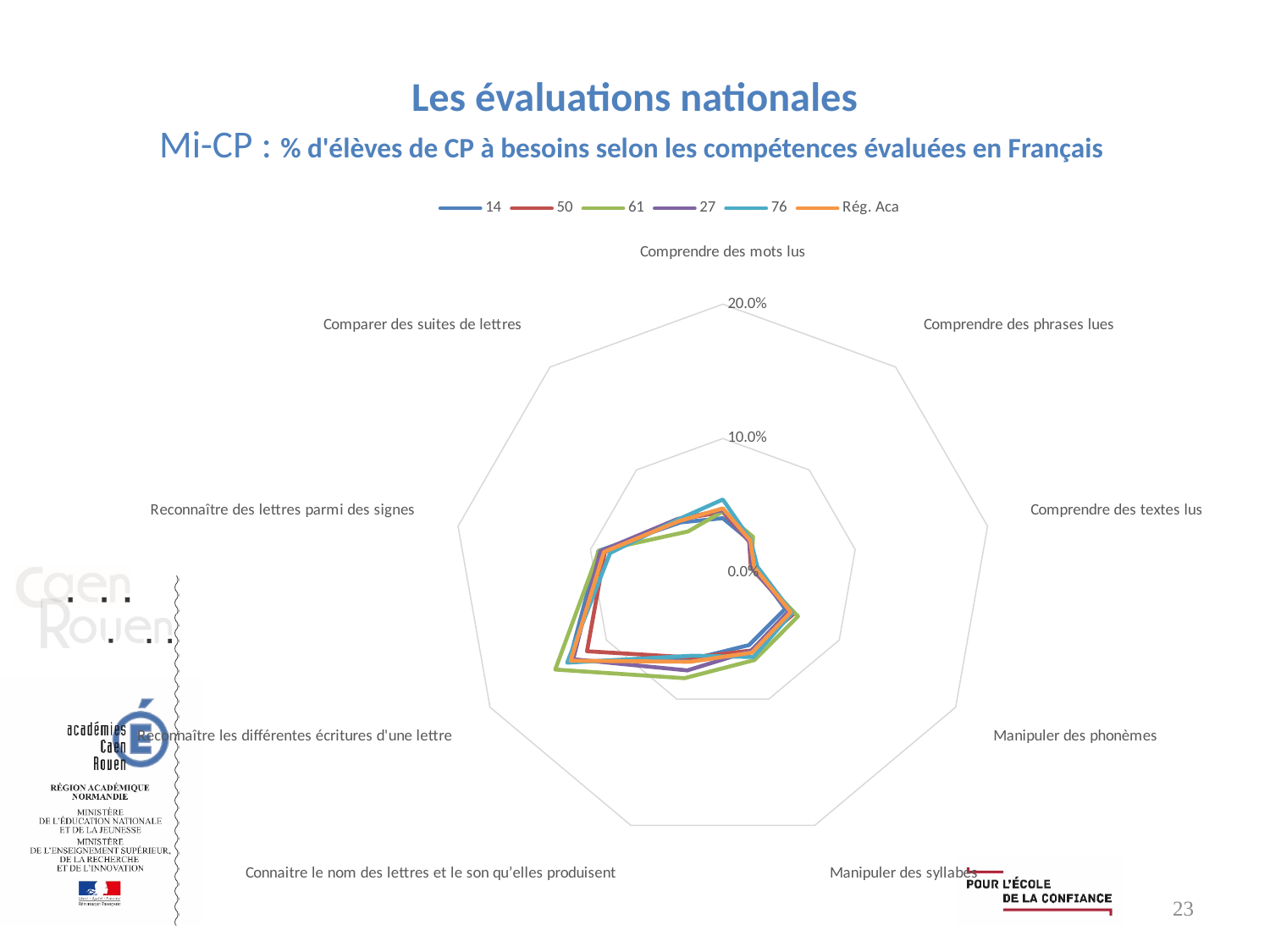
Which competency category has the highest values across the series? Reconnaître les différentes écritures d'une lettre How many series does the legend list? 6 What is the highest value shown on the radar chart's axis? 20.0% Which series is listed last in the legend? Rég. Aca Is the value for 'Comprendre des textes lus' for series 61 greater or less than 10.0%? less Is the value for 'Comprendre des mots lus' for series 76 greater or less than 10.0%? less For 'Connaitre le nom des lettres et le son qu'elles produisent', which series has the larger value, 61 or 50? 61 Which competency category has the lowest values across the series? Comprendre des textes lus Is the value for 'Manipuler des phonèmes' for series Rég. Aca greater or less than 10.0%? less What kind of chart is shown on the slide? Radar chart How many competency categories are plotted on the radar chart? 9